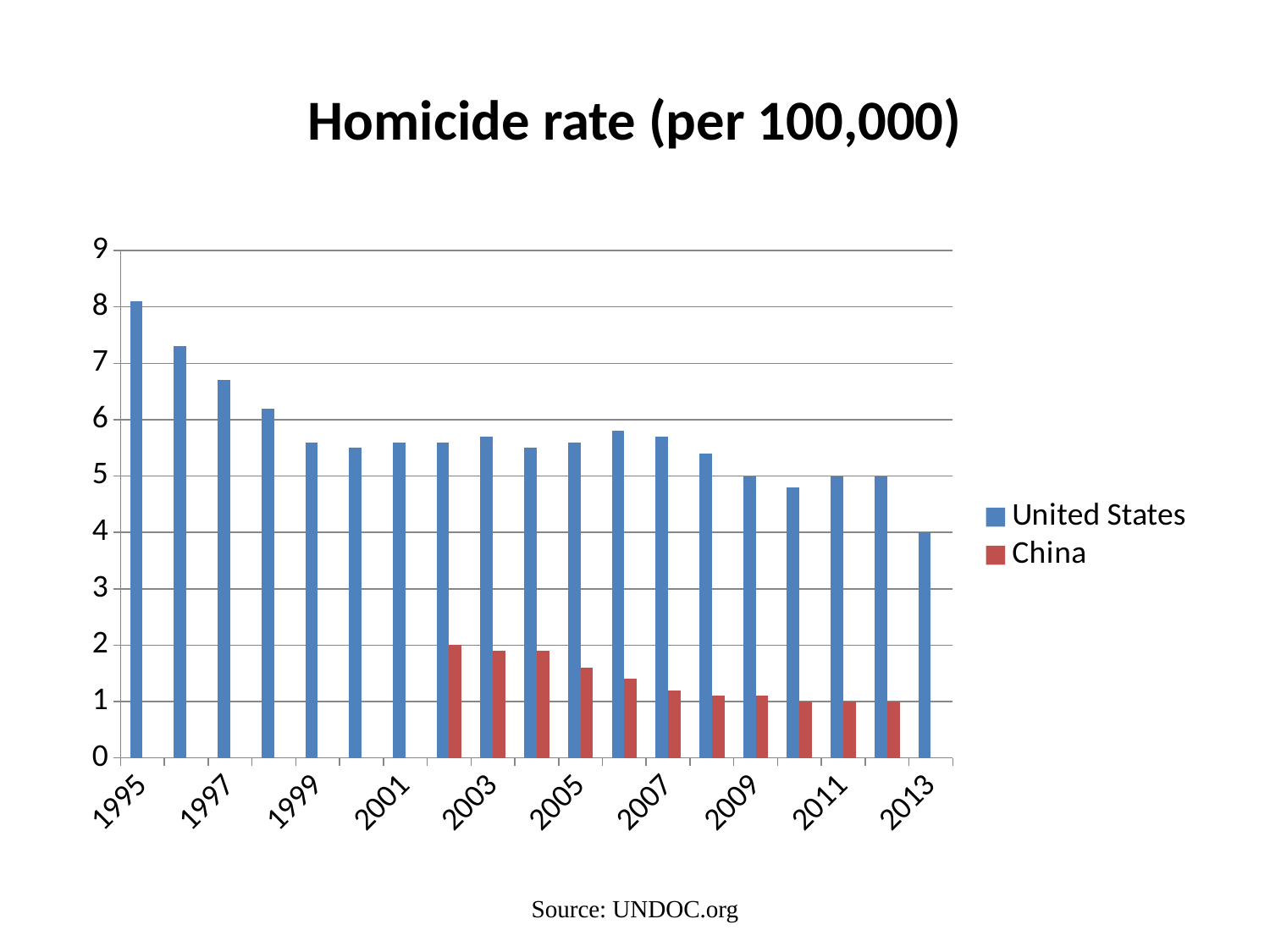
Which series is shown in red? China How many series does the legend list? 2 Is the United States homicide rate in 1997 greater or less than 6? greater In which year is the United States homicide rate highest? 1995 In which year is the China homicide rate highest? 2002 In which year is the United States homicide rate lowest? 2013 What kind of chart is shown on the slide? Bar chart What is the title of the chart? Homicide rate (per 100,000) Is the China homicide rate in 2005 greater or less than 2? less Which is larger in 2005, the homicide rate for the United States or for China? United States Does the United States homicide rate generally rise or fall from 1995 to 2013? Fall Is the United States homicide rate in 1995 greater or less than 7? greater